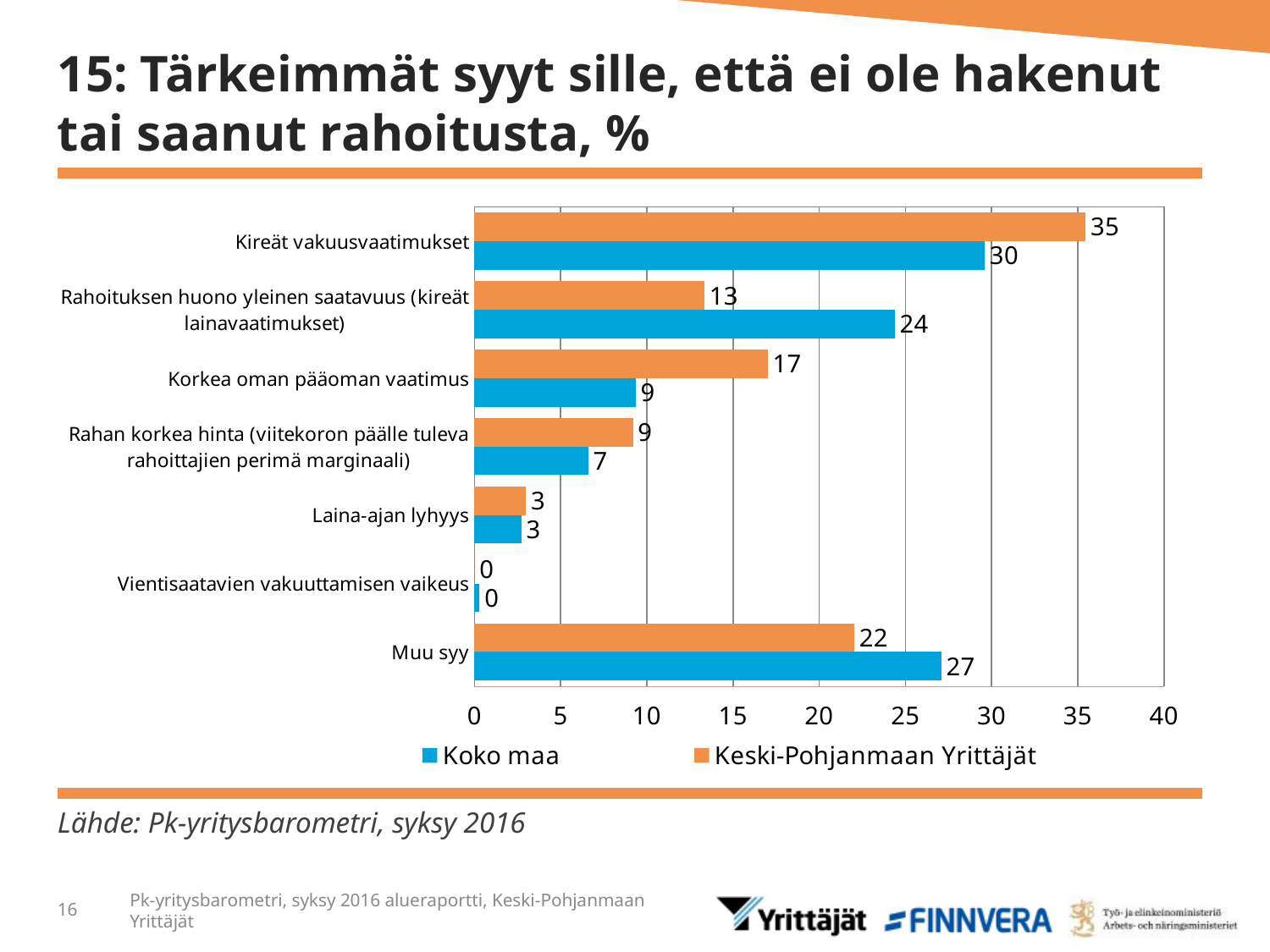
For Muu syy, which series has the larger value, Koko maa or Keski-Pohjanmaan Yrittäjät? Koko maa How many categories are shown on the chart? 7 Which category has the highest value for Koko maa? Kireät vakuusvaatimukset What kind of chart is shown on the slide? Bar chart What is the value for Keski-Pohjanmaan Yrittäjät for Korkea oman pääoman vaatimus? 17 Which colour represents the Koko maa series? Blue How many series does the legend list? 2 What is the value for Koko maa for Rahoituksen huono yleinen saatavuus (kireät lainavaatimukset)? 24 What is the value for Koko maa for Muu syy? 27 What is the value for Keski-Pohjanmaan Yrittäjät for Kireät vakuusvaatimukset? 35 What is the difference between the Koko maa and Keski-Pohjanmaan Yrittäjät values for Rahoituksen huono yleinen saatavuus (kireät lainavaatimukset)? 11 Which category has the lowest value for Keski-Pohjanmaan Yrittäjät? Vientisaatavien vakuuttamisen vaikeus